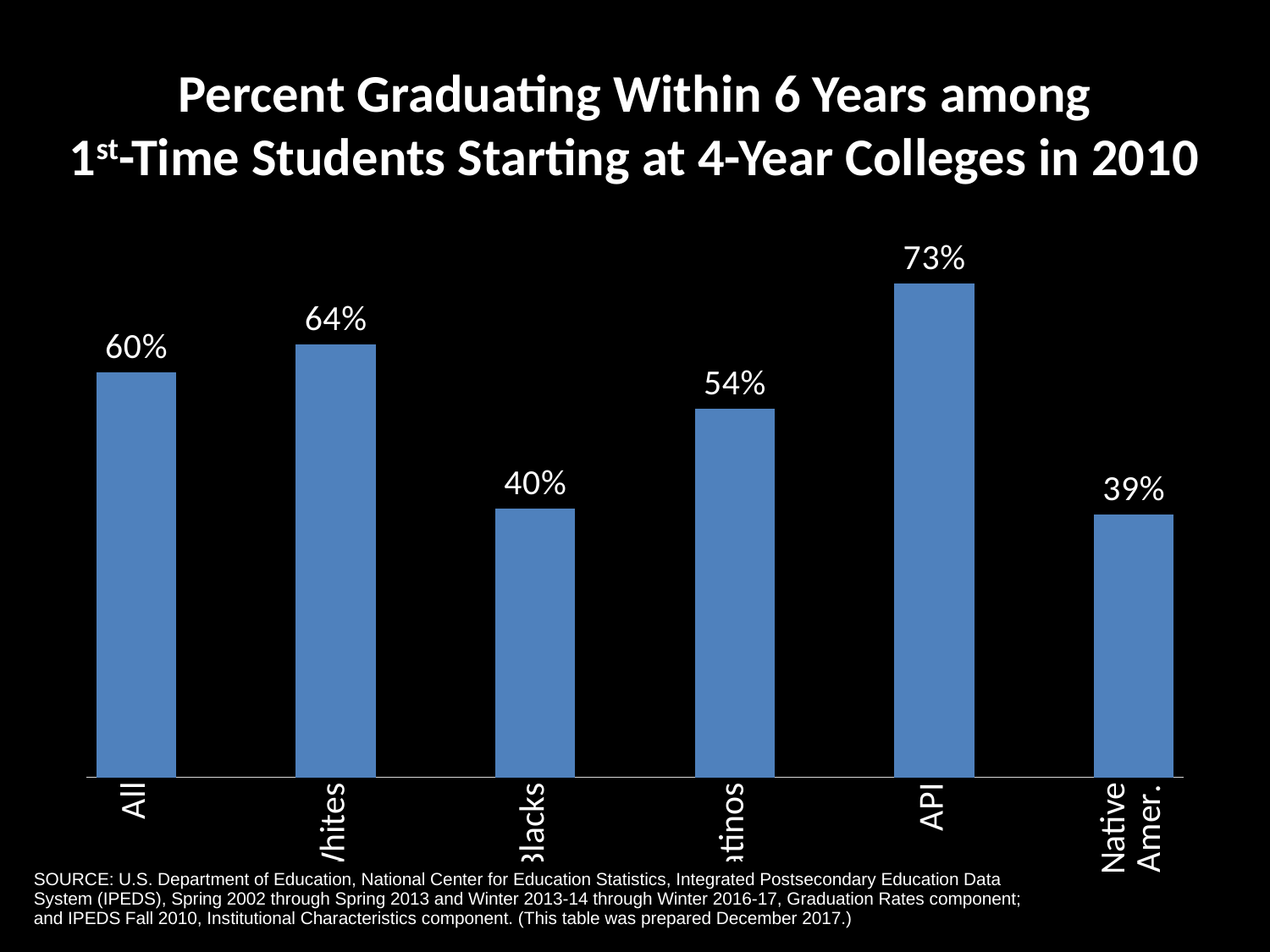
What is the value for API? 73% Which is larger, the value for Latinos or the value for Blacks? Latinos What is the value for Native Amer.? 39% Which category has the highest value? API What is the value for All? 60% What is the difference between the values for API and Native Amer.? 34% Which category has the lowest value? Native Amer. What is the title of the chart? Percent Graduating Within 6 Years among 1st-Time Students Starting at 4-Year Colleges in 2010 What kind of chart is shown on the slide? Bar chart What is the value for Whites? 64% What is the difference between the values for Whites and All? 4% How many categories are shown in the chart? 6